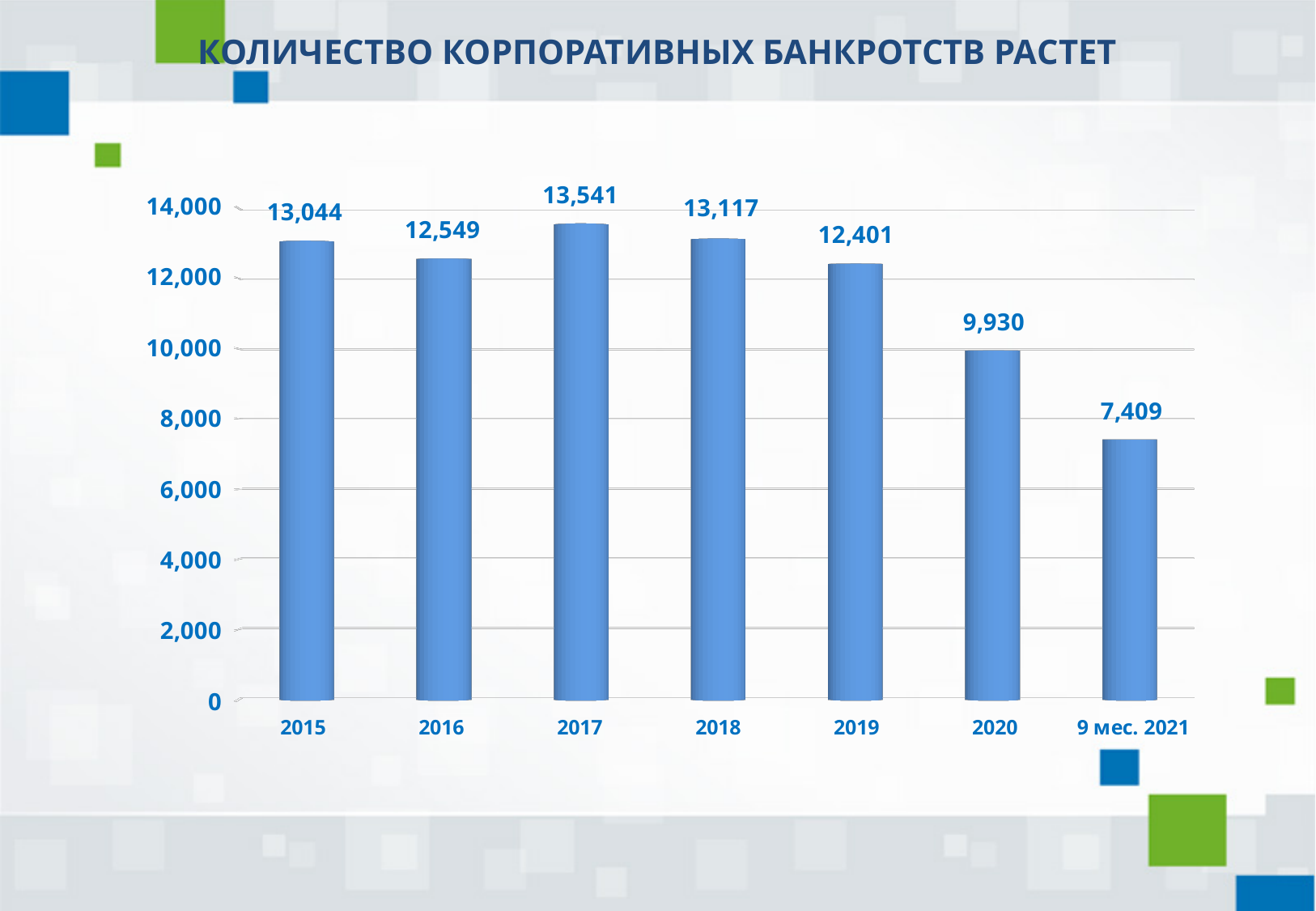
What is the title of the chart on the slide? КОЛИЧЕСТВО КОРПОРАТИВНЫХ БАНКРОТСТВ РАСТЕТ Which category has the lowest value? 9 мес. 2021 Is the value for 2020 greater or less than 10,000? less How many categories are shown on the x axis? 7 What is the value for 2017? 13,541 Which is larger, the value for 2015 or the value for 2018? 2018 What is the difference between the values for 2019 and 2020? 2,471 What is the value for 9 мес. 2021? 7,409 What is the difference between the values for 2017 and 2016? 992 What kind of chart is shown on the slide? bar chart Which category has the highest value? 2017 What is the value for 2020? 9,930